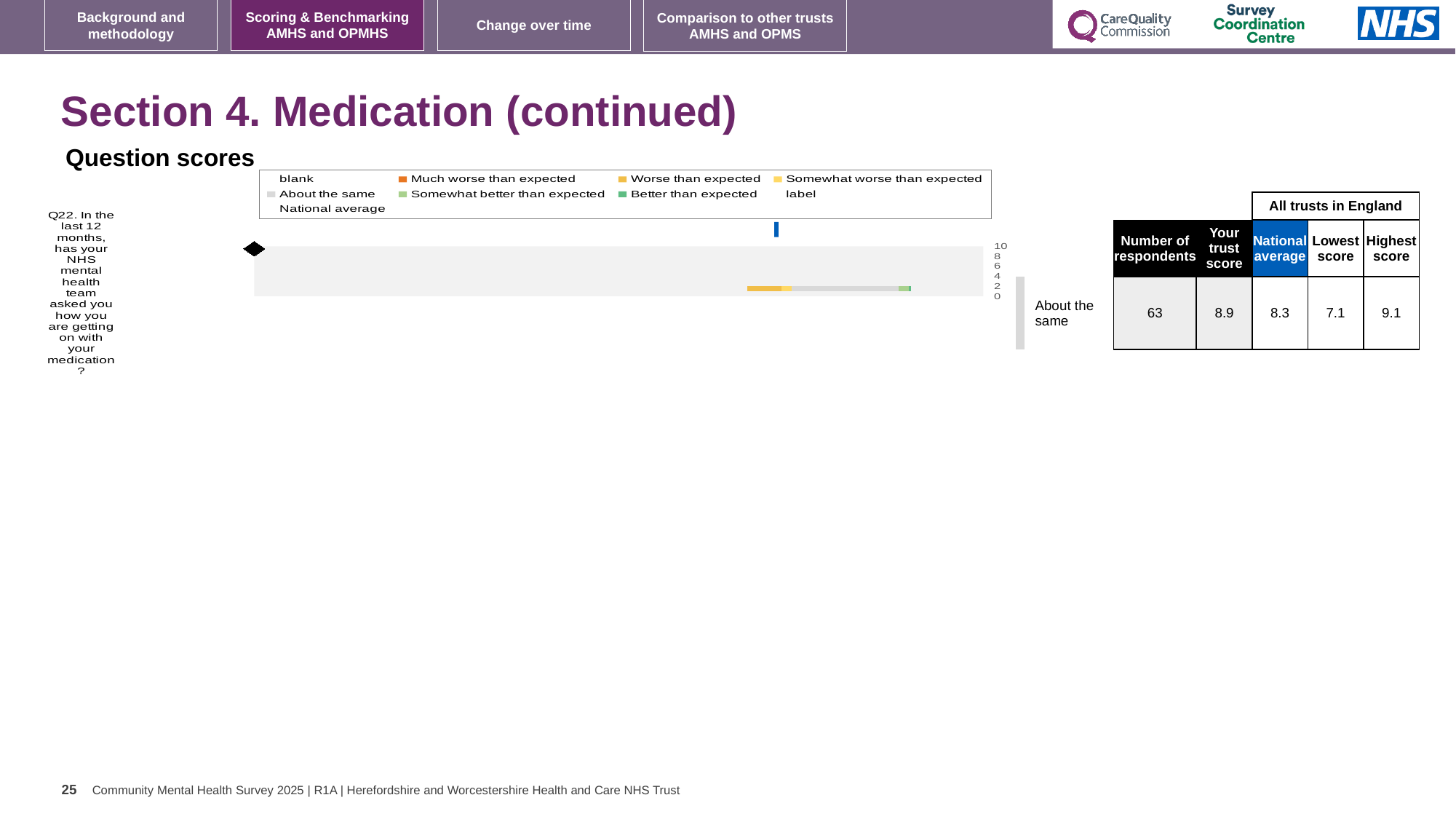
What is the maximum value shown on the score axis of the Question scores chart? 10 What is the national average score for Q22? 8.3 Which benchmark category is the trust's score for Q22 placed in? About the same Is the trust's score for Q22 higher or lower than the national average? higher Which legend entry is shown in orange on the Question scores chart? Much worse than expected What is the number of respondents for Q22? 63 What kind of chart is used to show the Q22 question score? bar chart What is the highest score among all trusts in England for Q22? 9.1 What is the difference between the highest and lowest scores for Q22 across all trusts in England? 2.0 What is the lowest score among all trusts in England for Q22? 7.1 How many questions are plotted on the Question scores chart? 1 What is the trust's score for Q22? 8.9